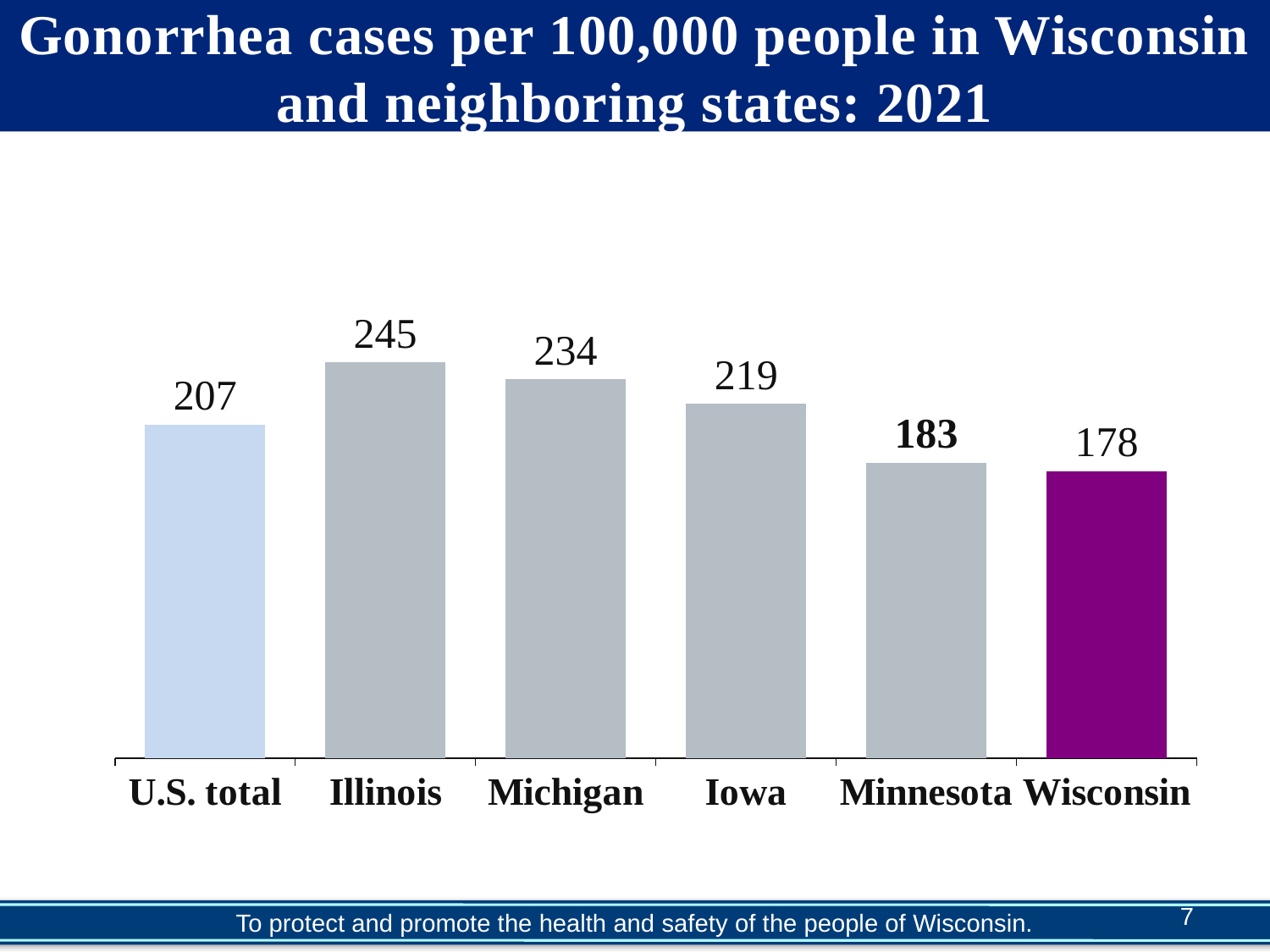
Which is larger, the value for Iowa or the value for the U.S. total? Iowa What is the gonorrhea rate per 100,000 people for Wisconsin? 178 What is the value shown for the U.S. total? 207 How many categories are shown on the x axis? 6 What is the title of the chart on the slide? Gonorrhea cases per 100,000 people in Wisconsin and neighboring states: 2021 Which category has the highest gonorrhea rate? Illinois What is the difference between the Illinois and Wisconsin values? 67 What kind of chart is shown on the slide? Bar chart What is the value shown for Minnesota? 183 Which category has the lowest gonorrhea rate? Wisconsin What is the gonorrhea rate per 100,000 people for Illinois? 245 What is the difference between the Michigan and Iowa values? 15